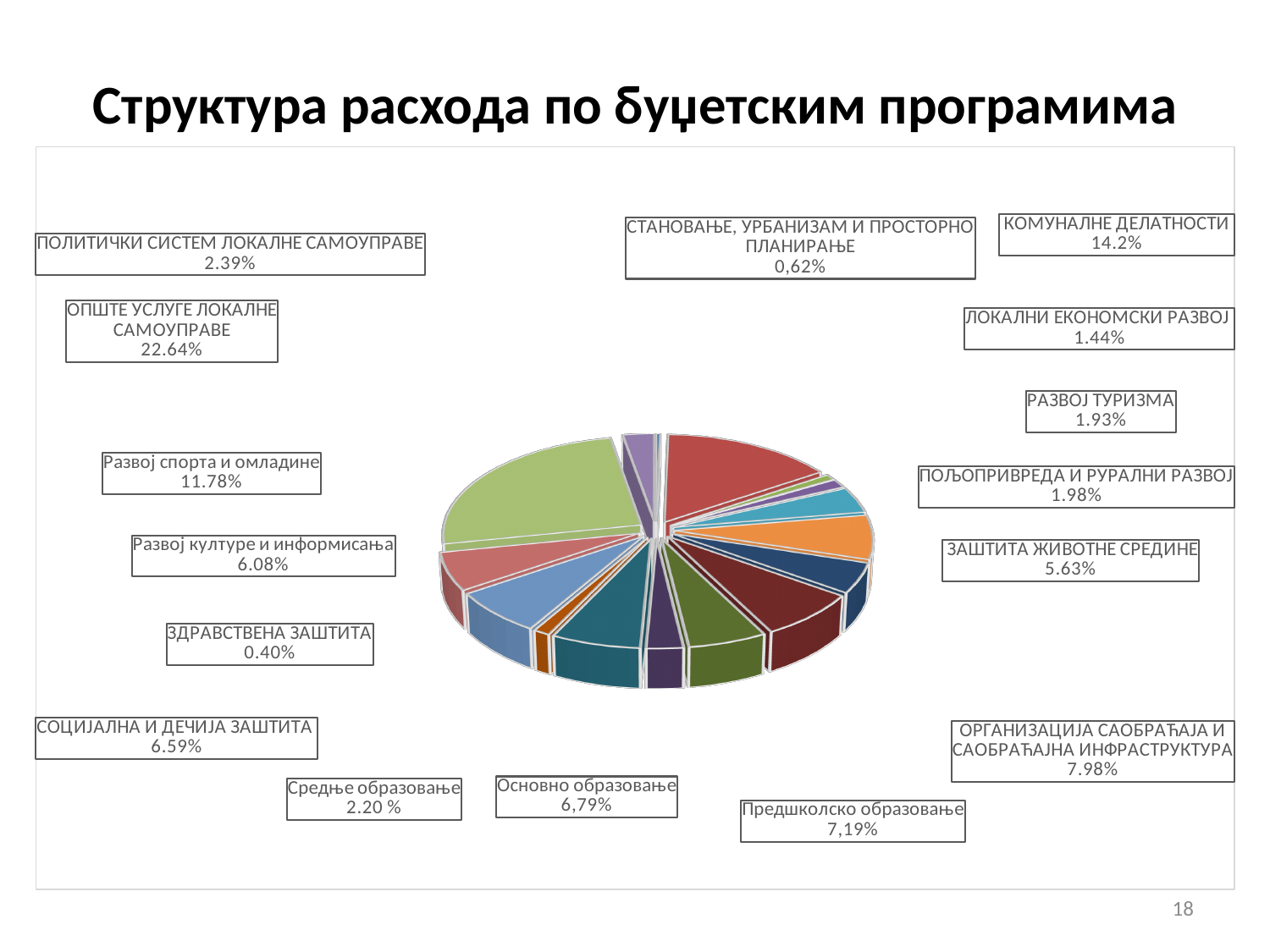
What share is shown for ОПШТЕ УСЛУГЕ ЛОКАЛНЕ САМОУПРАВЕ? 22.64% What share is shown for ЗДРАВСТВЕНА ЗАШТИТА? 0.40% What share is shown for КОМУНАЛНЕ ДЕЛАТНОСТИ? 14.2% How many labeled categories are shown in the pie chart? 16 What type of chart is shown on the slide? Pie chart What is the difference in percentage points between ОПШТЕ УСЛУГЕ ЛОКАЛНЕ САМОУПРАВЕ and КОМУНАЛНЕ ДЕЛАТНОСТИ? 8.44 percentage points Which category has the largest share in the pie chart? ОПШТЕ УСЛУГЕ ЛОКАЛНЕ САМОУПРАВЕ Which has a larger share: Предшколско образовање or Основно образовање? Предшколско образовање What share is shown for Развој спорта и омладине? 11.78% Which category has the smallest share in the pie chart? ЗДРАВСТВЕНА ЗАШТИТА What share is shown for Предшколско образовање? 7,19% What is the title of the chart on the slide? Структура расхода по буџетским програмима